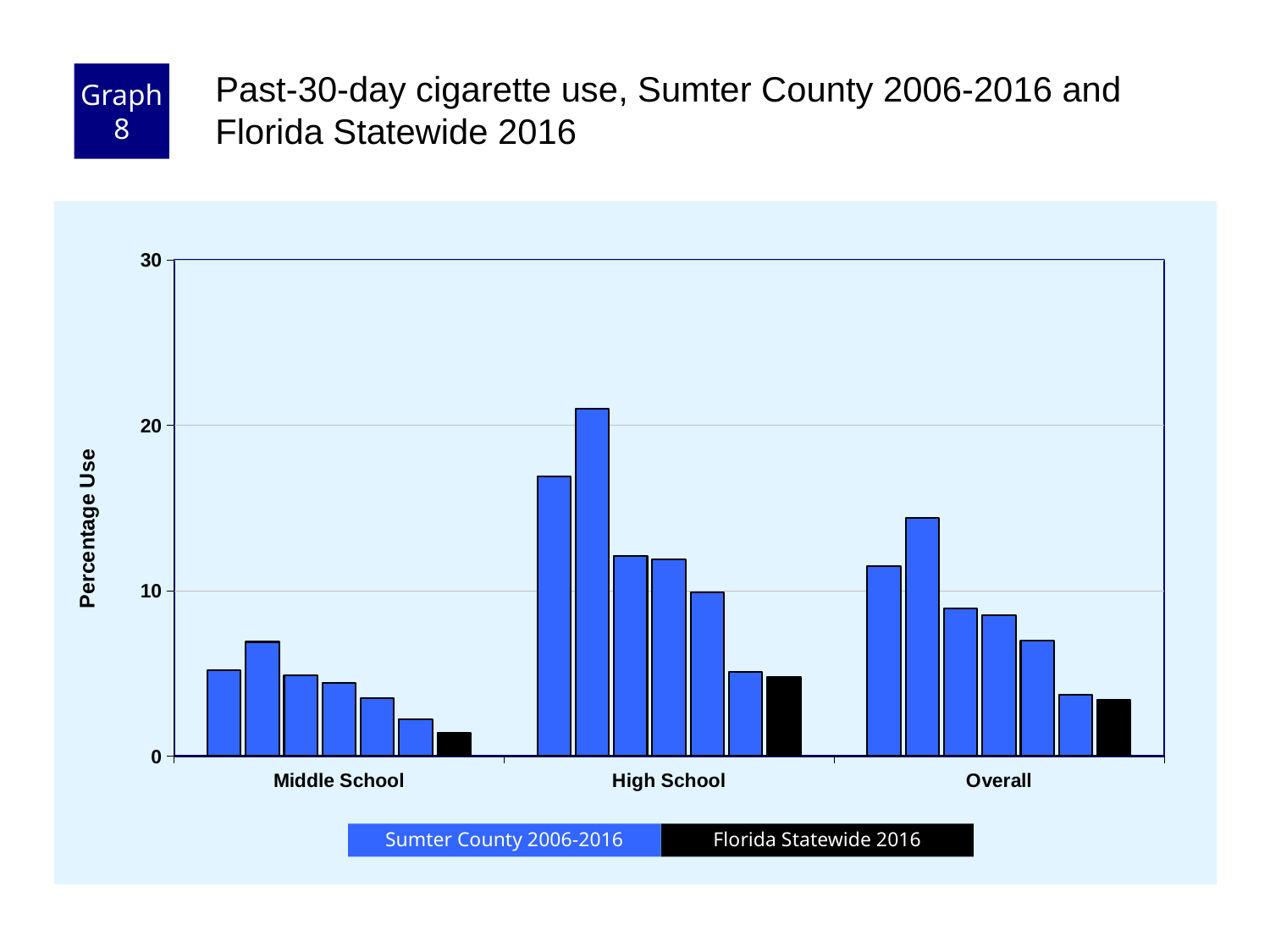
What is the label on the y axis? Percentage Use Which colour represents Florida Statewide 2016 in the legend? black How many series does the legend list? 2 Which category has the tallest bar overall? High School What kind of chart is shown on the slide? bar chart Is the tallest Sumter County bar for Middle School greater or less than 10? less How many categories are shown on the x axis? 3 Is the Florida Statewide 2016 value for High School greater or less than 10? less Which is larger, the Florida Statewide 2016 value for High School or for Middle School? High School Is the tallest Sumter County bar for Overall greater or less than 10? greater Which category has the lowest bars overall? Middle School